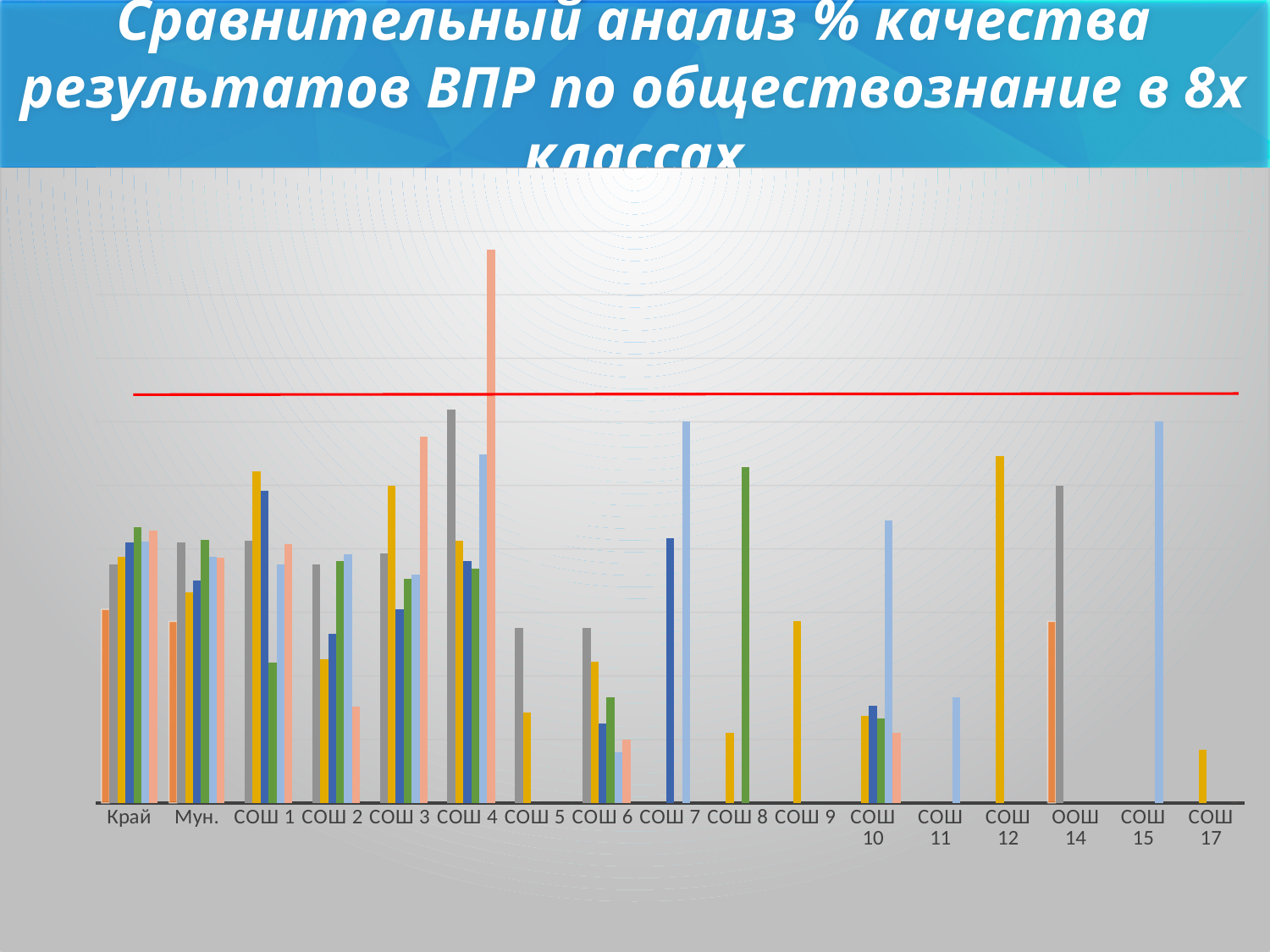
Which category contains the tallest bar in the chart? СОШ 4 How many categories are shown along the x axis of the chart? 17 Is the bar for СОШ 9 taller or shorter than the bar for СОШ 17? taller What kind of chart is shown on the slide? bar chart Is the bar for СОШ 11 taller or shorter than the bar for СОШ 15? shorter Is the tallest bar for СОШ 7 taller or shorter than the tallest bar for СОШ 6? taller What is the first category on the x axis of the chart? Край What is the title of the slide containing the chart? Сравнительный анализ % качества результатов ВПР по обществознание в 8х классах